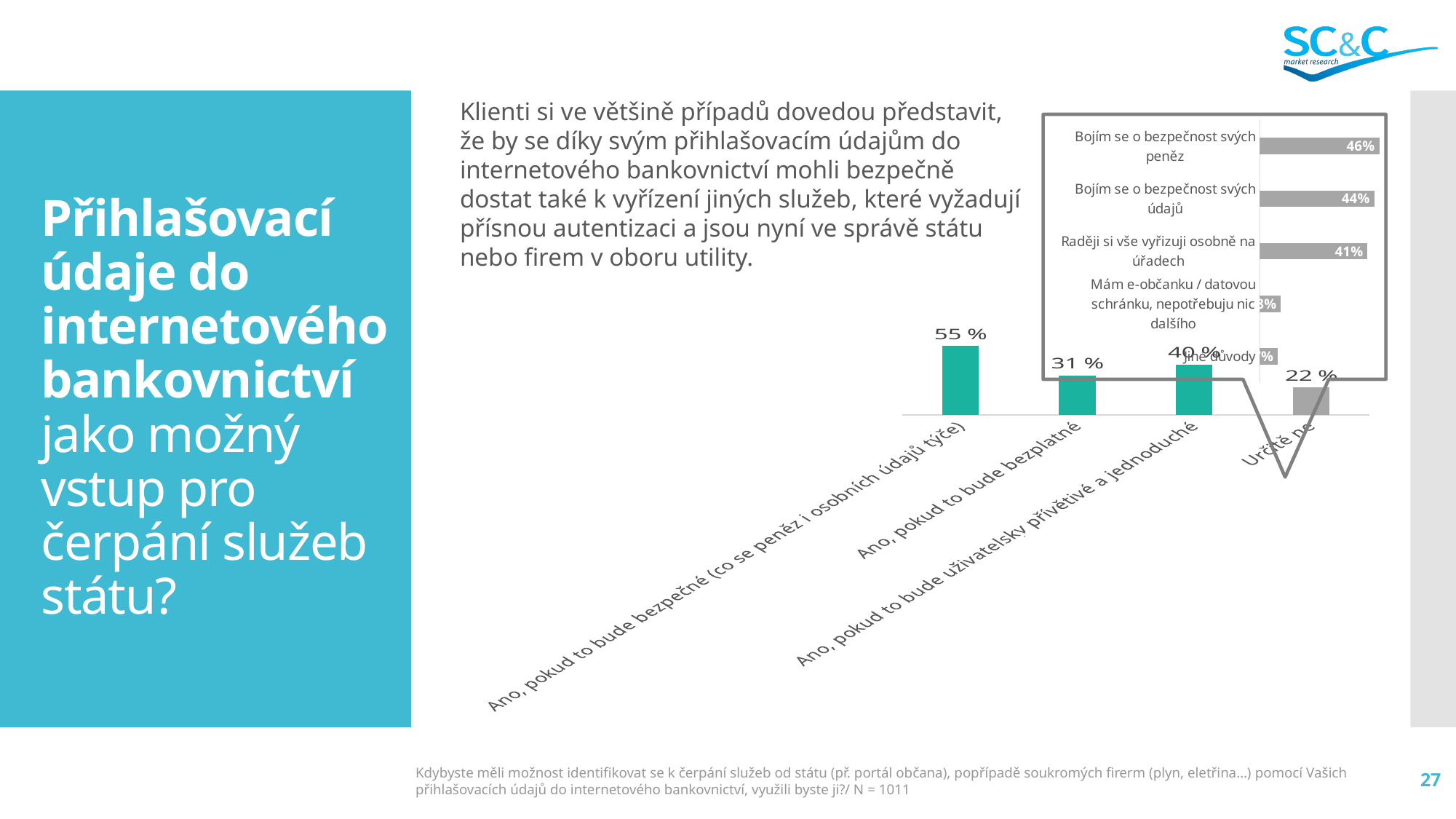
In the main bar chart, what is the difference between "Ano, pokud to bude bezpečné (co se peněz i osobních údajů týče)" and "Určitě ne"? 33 % In the inset chart at the top right, what is the difference between "Bojím se o bezpečnost svých peněz" and "Bojím se o bezpečnost svých údajů"? 2% In the inset chart at the top right, what is the value for "Raději si vše vyřizuji osobně na úřadech"? 41% In the main bar chart, what is the value for "Ano, pokud to bude bezpečné (co se peněz i osobních údajů týče)"? 55 % In the main bar chart, which category has the lowest value? Určitě ne In the inset chart at the top right, what is the value for "Bojím se o bezpečnost svých peněz"? 46% How many categories does the main bar chart show? 4 In the main bar chart, which category has the highest value? Ano, pokud to bude bezpečné (co se peněz i osobních údajů týče) In the main bar chart, which is larger: "Ano, pokud to bude bezplatné" or "Ano, pokud to bude uživatelsky přívětivé a jednoduché"? Ano, pokud to bude uživatelsky přívětivé a jednoduché In the main bar chart, what is the value for "Určitě ne"? 22 % In the main bar chart, what is the value for "Ano, pokud to bude bezplatné"? 31 % What kind of chart is the main chart on the slide? Bar chart